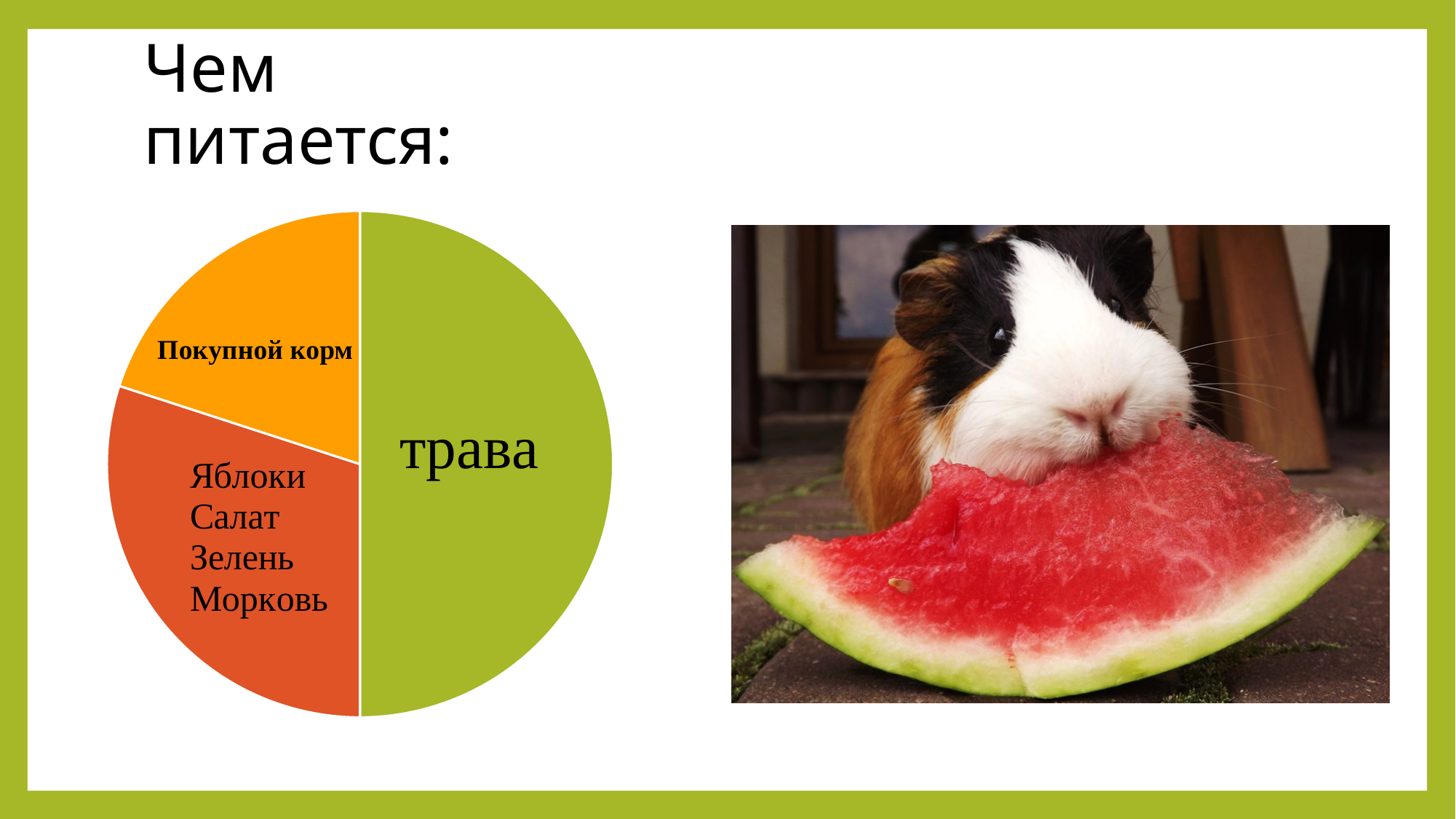
Which slice is larger: "Покупной корм" or "Яблоки Салат Зелень Морковь"? Яблоки Салат Зелень Морковь What colour is the "трава" slice of the pie chart? green Which slice of the pie chart is the smallest? Покупной корм What is the title of the slide containing the pie chart? Чем питается: How many slices does the pie chart have? 3 Which slice is larger: "трава" or "Покупной корм"? трава What kind of chart is shown on the slide? pie chart Which slice of the pie chart is the largest? трава